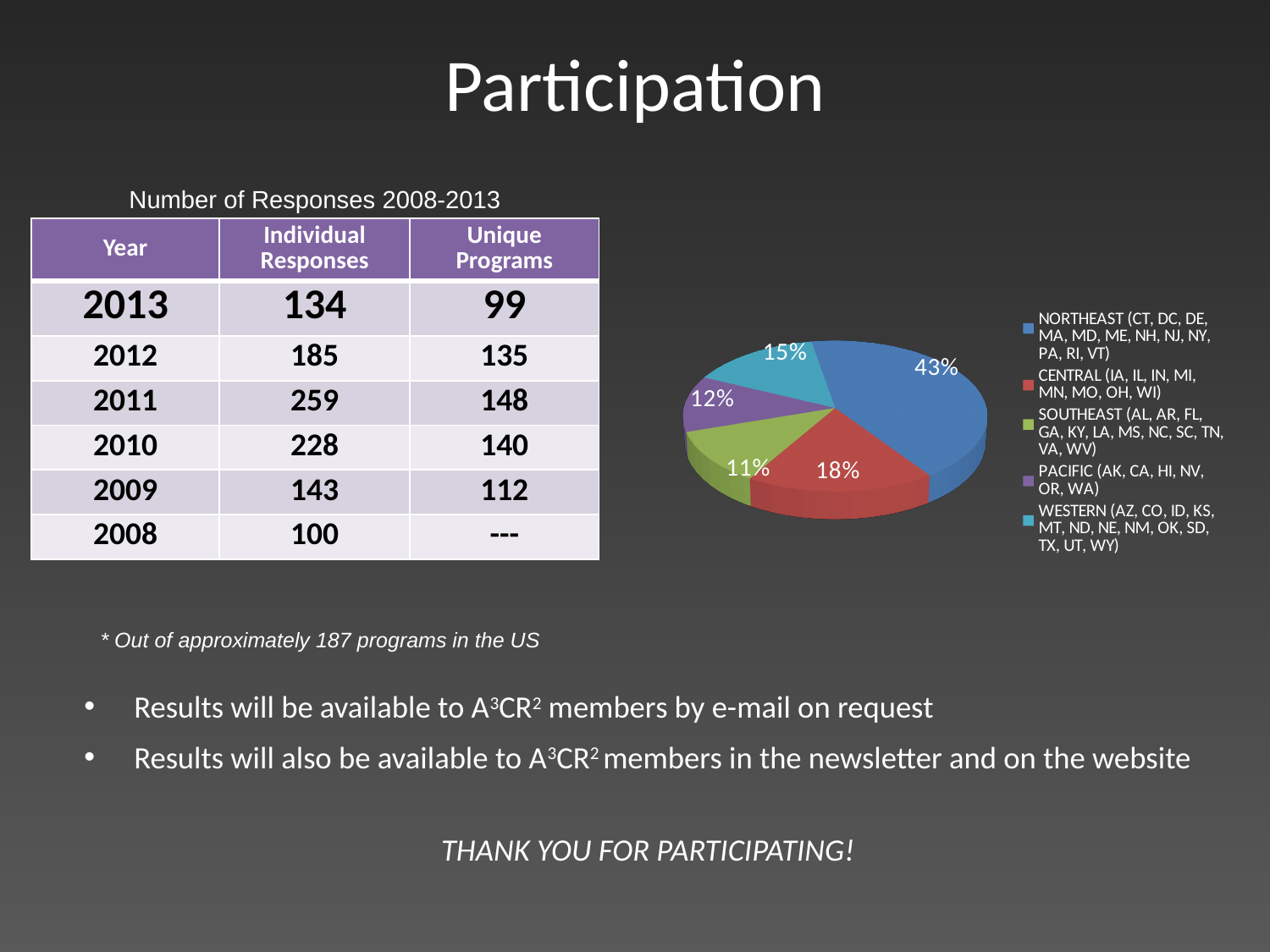
What colour is the NORTHEAST slice in the pie chart? blue What share of the pie chart does the PACIFIC region have? 12% What share of the pie chart does the SOUTHEAST region have? 11% Which region has the largest slice of the pie chart? NORTHEAST Which slice of the pie chart is larger, WESTERN or PACIFIC? WESTERN What is the difference in percentage points between the NORTHEAST and CENTRAL slices of the pie chart? 25 What share of the pie chart does the WESTERN region have? 15% How many regions are shown in the pie chart? 5 Which region has the smallest slice of the pie chart? SOUTHEAST What kind of chart is shown on the slide? pie chart